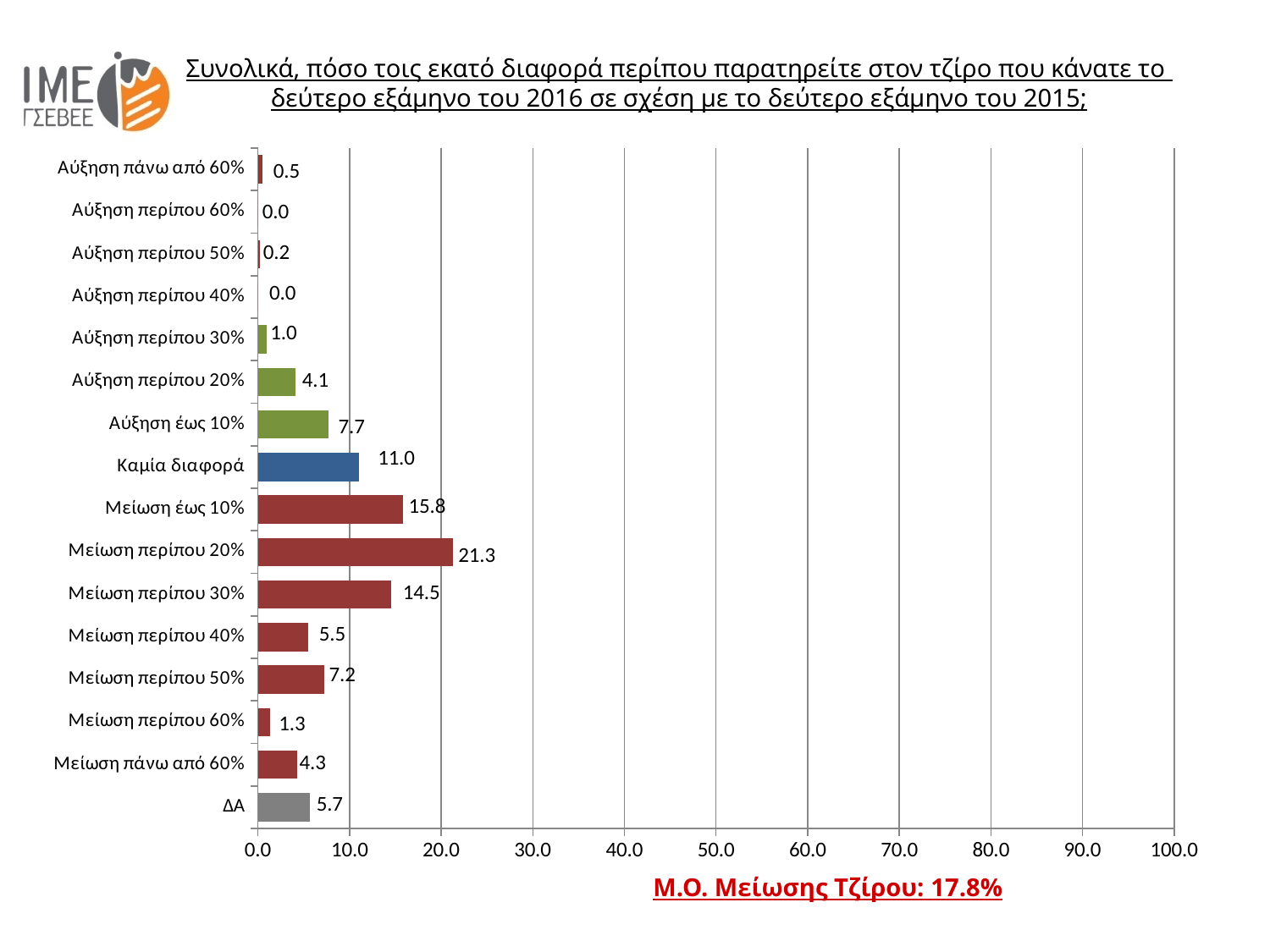
What is the difference between the values for "Μείωση περίπου 20%" and "Μείωση έως 10%"? 5.5 Is the value for "Μείωση έως 10%" greater or less than 10.0? greater How many categories are shown on the chart? 16 Which is larger, the value for "Μείωση περίπου 50%" or the value for "Μείωση περίπου 40%"? Μείωση περίπου 50% What is the value for "Μείωση περίπου 20%"? 21.3 What kind of chart is shown on the slide? bar chart Which category has the highest value? Μείωση περίπου 20% What is the difference between the values for "Μείωση περίπου 30%" and "Καμία διαφορά"? 3.5 What is the value for "Αύξηση έως 10%"? 7.7 What is the value for "ΔΑ"? 5.7 What is the value for "Καμία διαφορά"? 11.0 What average turnover decrease (Μ.Ο. Μείωσης Τζίρου) is stated below the chart? 17.8%